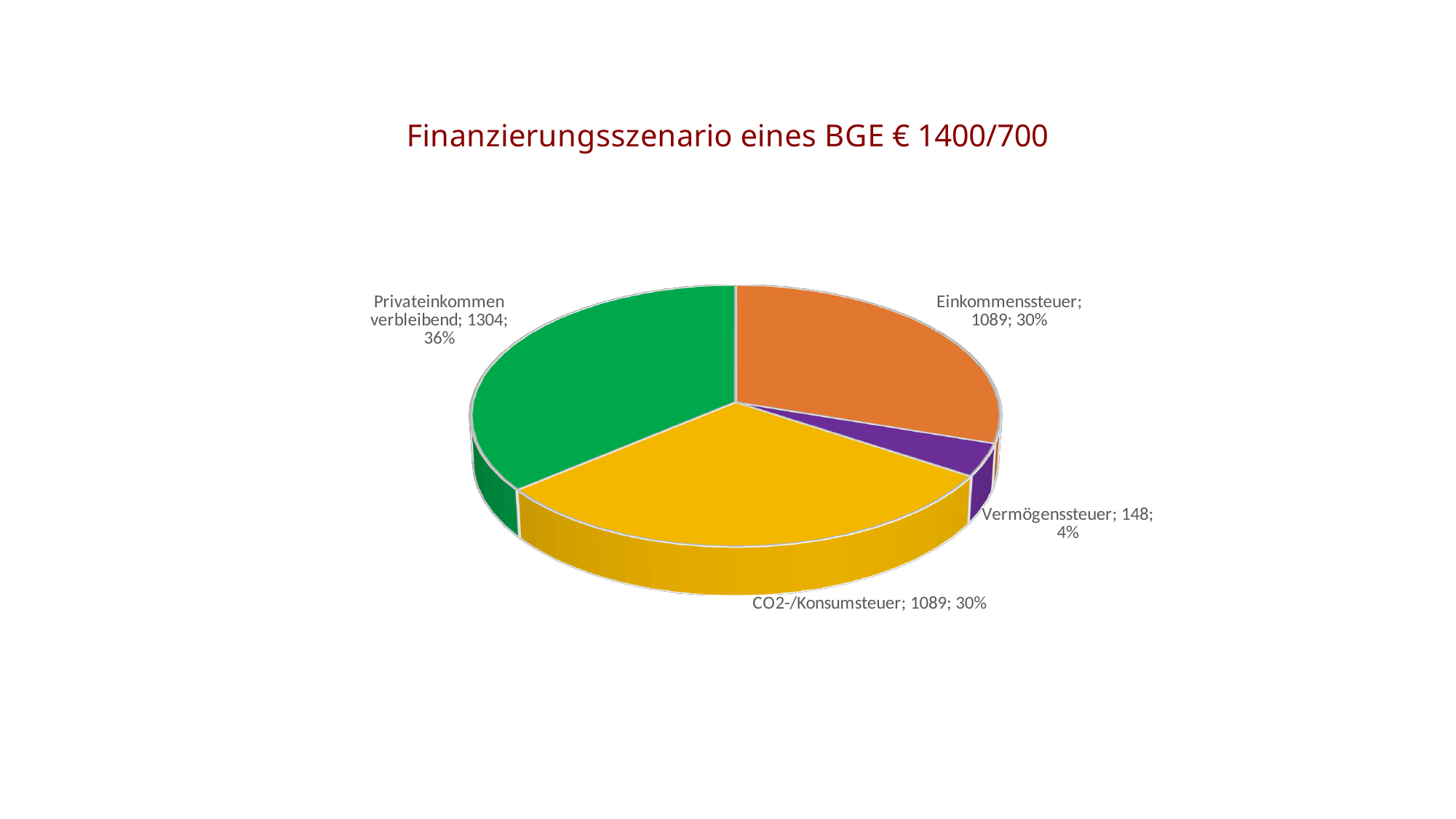
How many slices does the pie chart have? 4 Which is larger, the value for Einkommenssteuer or the value for Vermögenssteuer? Einkommenssteuer What is the value for Privateinkommen verbleibend? 1304 Which category has the largest slice? Privateinkommen verbleibend What kind of chart is shown on the slide? Pie chart What is the value for Einkommenssteuer? 1089 Which category has the smallest slice? Vermögenssteuer What share of the pie does CO2-/Konsumsteuer represent? 30% What share of the pie does Privateinkommen verbleibend represent? 36% What is the value for Vermögenssteuer? 148 What is the title of the chart? Finanzierungsszenario eines BGE € 1400/700 What is the difference between the values for Privateinkommen verbleibend and Einkommenssteuer? 215